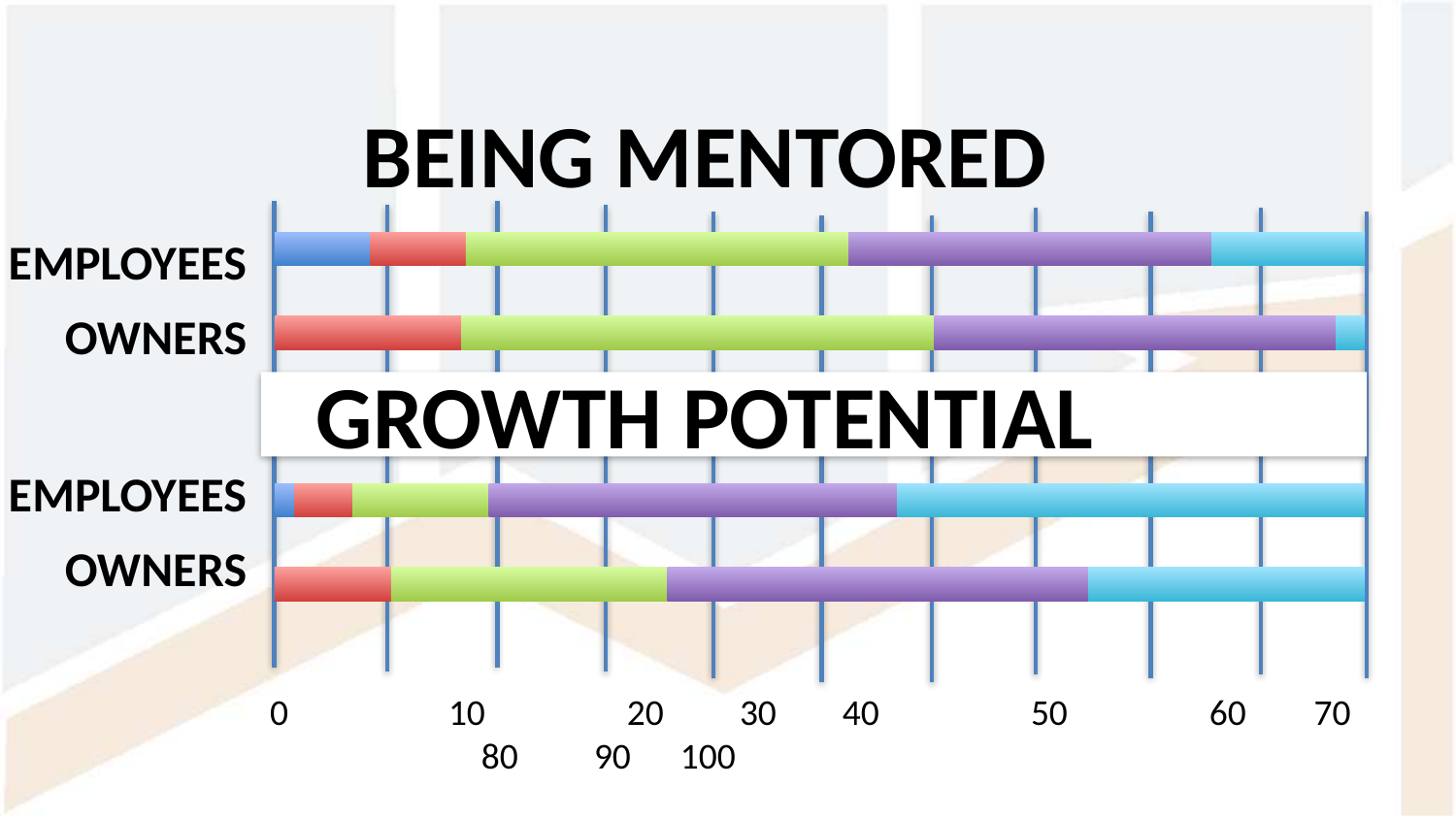
What kind of chart is shown on the slide? bar chart How many coloured segments make up the Owners bar under Growth Potential? 4 Under Being Mentored, is the width of the light-blue segment in the Owners bar greater or less than 10? less How many coloured segments make up the Employees bar under Being Mentored? 5 How many bars are plotted on the slide in total? 4 Under Being Mentored, which bar has the larger green segment, Employees or Owners? Owners Under Being Mentored, which bar has the larger light-blue (rightmost) segment, Employees or Owners? Employees Under Being Mentored, is the width of the green segment in the Owners bar greater or less than 30? greater What are the two section titles shown above the groups of bars? Being Mentored and Growth Potential Under Growth Potential, is the width of the red segment in the Owners bar greater or less than 20? less Under Growth Potential, which bar has the larger light-blue (rightmost) segment, Employees or Owners? Employees